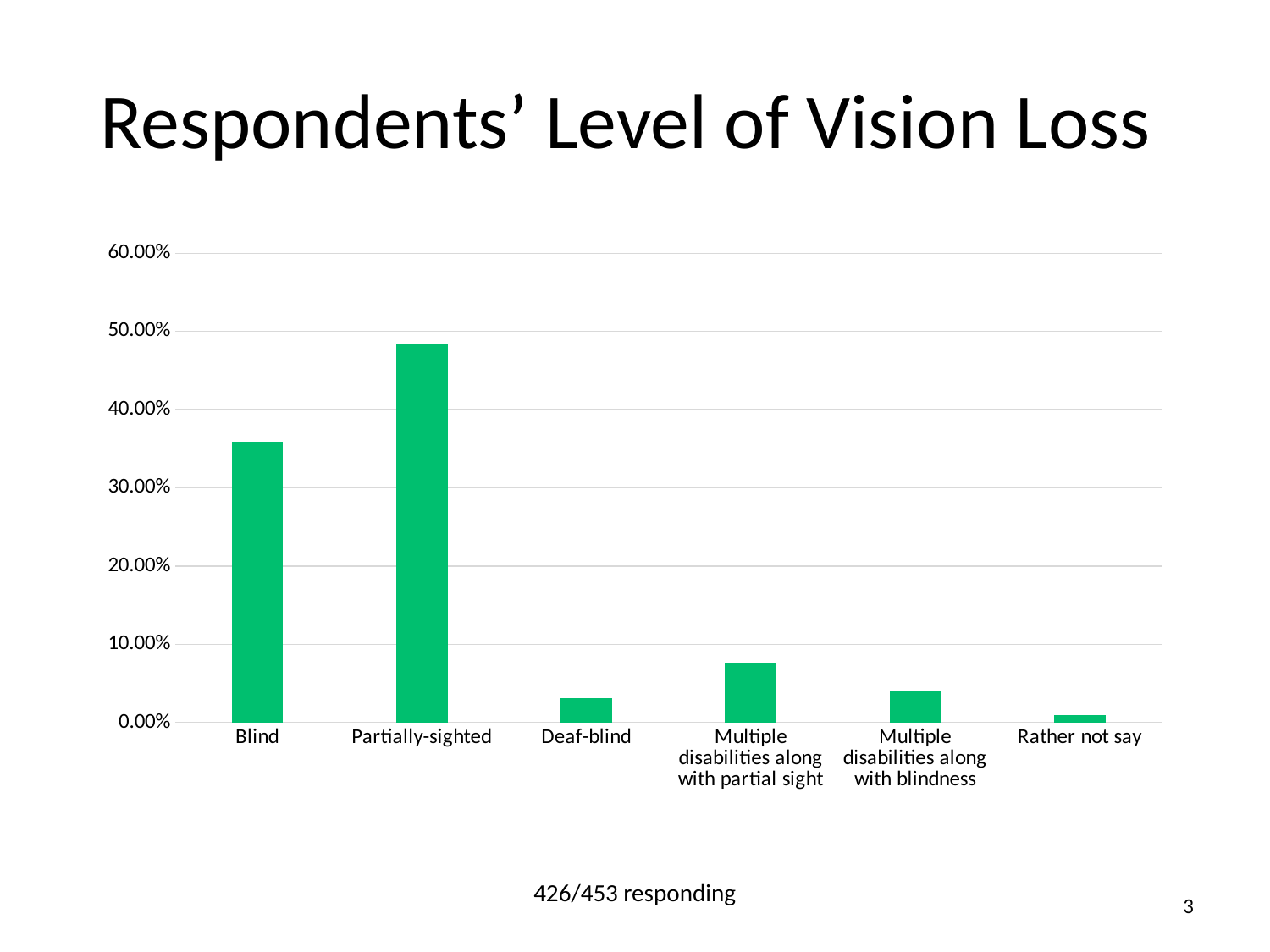
Is the value for Blind greater or less than 30.00%? greater Is the value for Deaf-blind greater or less than 10.00%? less How many categories are shown on the x axis of the chart? 6 What is the title of the chart on the slide? Respondents' Level of Vision Loss Is the value for Partially-sighted greater or less than 40.00%? greater Which category has the highest value in the chart? Partially-sighted Which is larger, the value for Blind or the value for Partially-sighted? Partially-sighted Which category has the lowest value in the chart? Rather not say Which is larger, the value for Deaf-blind or the value for Multiple disabilities along with partial sight? Multiple disabilities along with partial sight What kind of chart is shown on the slide? bar chart